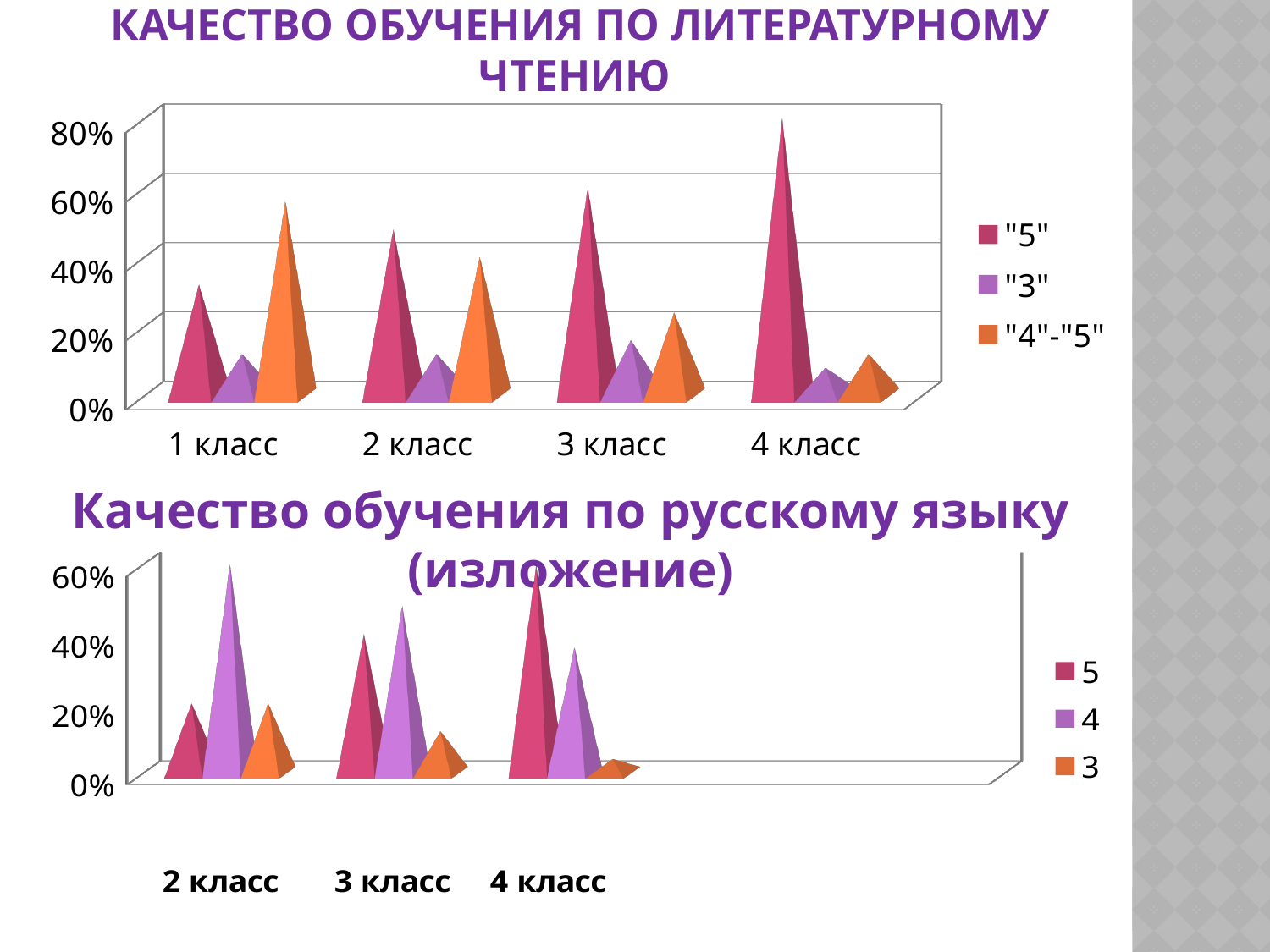
What kind of chart is the top chart titled "КАЧЕСТВО ОБУЧЕНИЯ ПО ЛИТЕРАТУРНОМУ ЧТЕНИЮ"? bar chart In the bottom chart (Russian language, изложение), does series 5 rise or fall from 2 класс to 4 класс? rise In the top chart (literary reading), which is larger for 3 класс: the "5" series or the "4"-"5" series? "5" In the top chart (literary reading), does the "5" series rise or fall from 1 класс to 4 класс? rise What series names does the legend of the bottom chart (Russian language, изложение) list? 5, 4, 3 In the top chart (literary reading), is the value of "5" for 4 класс greater or less than 60%? greater How many categories are shown on the x axis of the bottom chart (Russian language, изложение)? 3 How many categories are shown on the x axis of the top chart (literary reading)? 4 In the top chart (literary reading), is the value of "4"-"5" for 1 класс greater or less than 40%? greater How many series does the legend of the top chart (literary reading) list? 3 In the top chart (literary reading), which category has the highest value for the "5" series? 4 класс In the bottom chart (Russian language, изложение), which category has the highest value for series 4? 2 класс